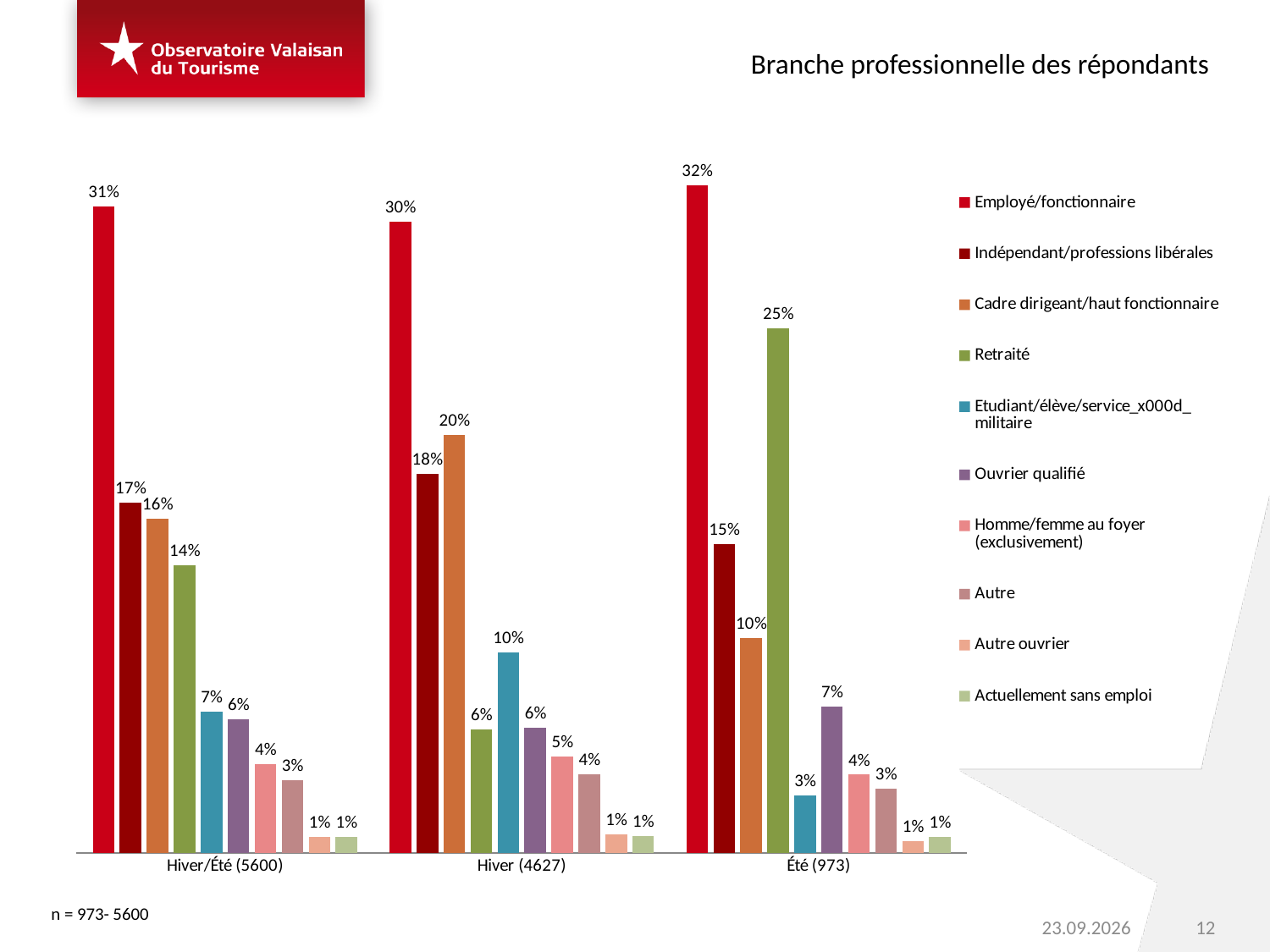
What kind of chart is shown on the slide? Bar chart What is the value for Cadre dirigeant/haut fonctionnaire in the Hiver/Été (5600) group? 16% What is the difference between the Retraité values for Été (973) and Hiver (4627)? 19% In which group is the value for Retraité the highest? Été (973) What is the value for Retraité in the Hiver (4627) group? 6% What is the value for Employé/fonctionnaire in the Été (973) group? 32% What is the title of the chart? Branche professionnelle des répondants How many series does the legend list? 10 Which is larger in the Hiver (4627) group: Indépendant/professions libérales or Cadre dirigeant/haut fonctionnaire? Cadre dirigeant/haut fonctionnaire How many categories are shown on the x axis? 3 What is the difference between the Etudiant/élève/service militaire values for Hiver (4627) and Été (973)? 7% Which series has the highest value in the Été (973) group? Employé/fonctionnaire